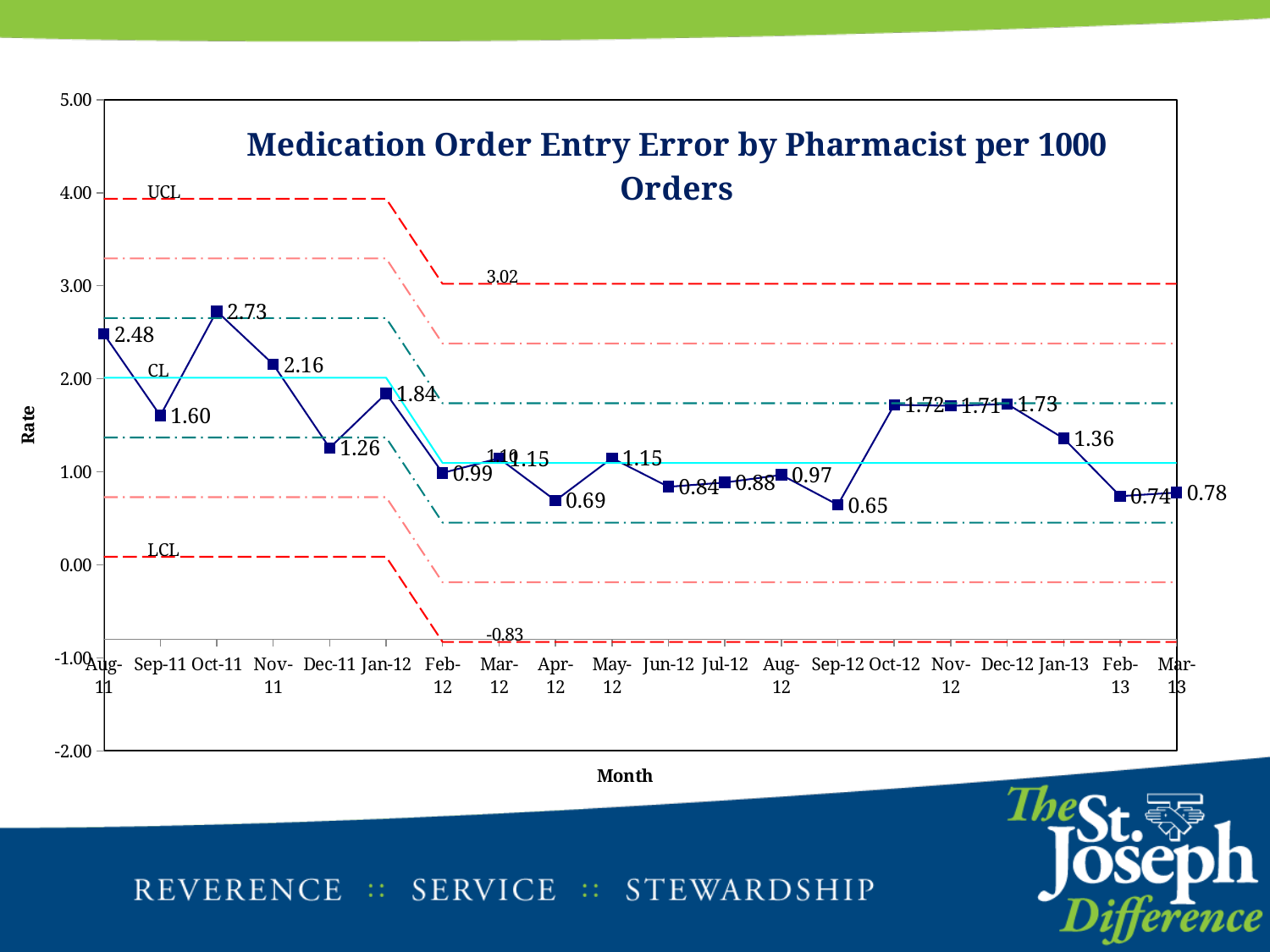
What is the title of the chart? Medication Order Entry Error by Pharmacist per 1000 Orders What is the difference between the rates for Aug-11 and Sep-11? 0.88 What kind of chart is shown on the slide? line chart How many months are plotted on the x axis? 20 Which month has the higher rate, Dec-11 or Jan-12? Jan-12 Which month has the highest rate? Oct-11 What is the value of the upper control limit (UCL) from Feb-12 onward? 3.02 What is the label of the vertical axis? Rate What is the rate for Aug-11? 2.48 Which month has the lowest rate? Sep-12 What is the rate for Jan-13? 1.36 What is the rate for Sep-12? 0.65